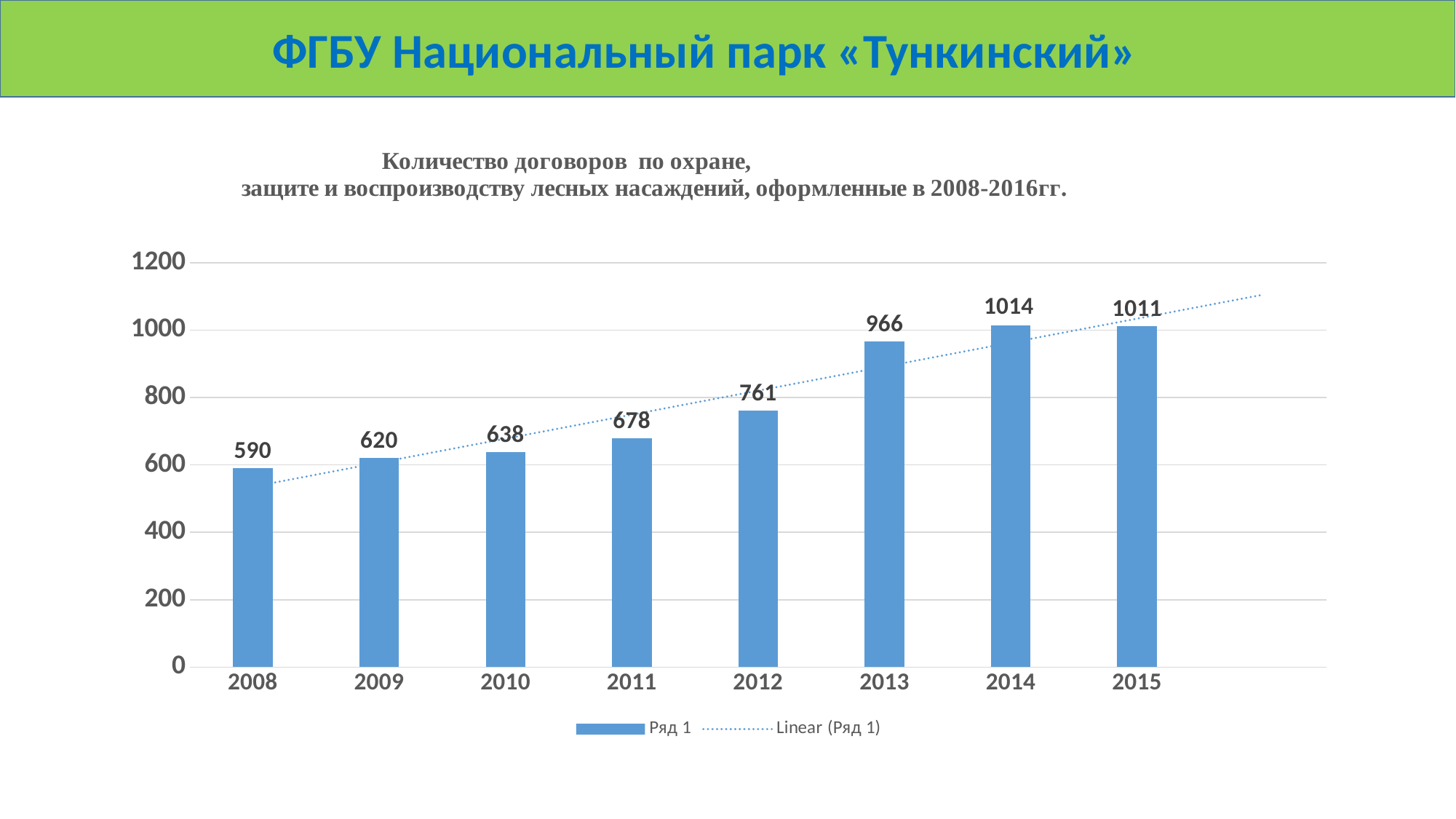
Which year has the highest value? 2014 Which year has the lowest value? 2008 Do the values generally rise or fall from 2008 to 2014? rise What kind of chart is this? bar chart Is the value for 2012 greater or less than 800? less What is the value for 2008? 590 What is the value for 2013? 966 What is the difference between the values for 2013 and 2012? 205 Which is larger, the value for 2011 or the value for 2012? 2012 What is the value for 2015? 1011 What is the difference between the values for 2014 and 2008? 424 How many years are shown on the x axis? 8